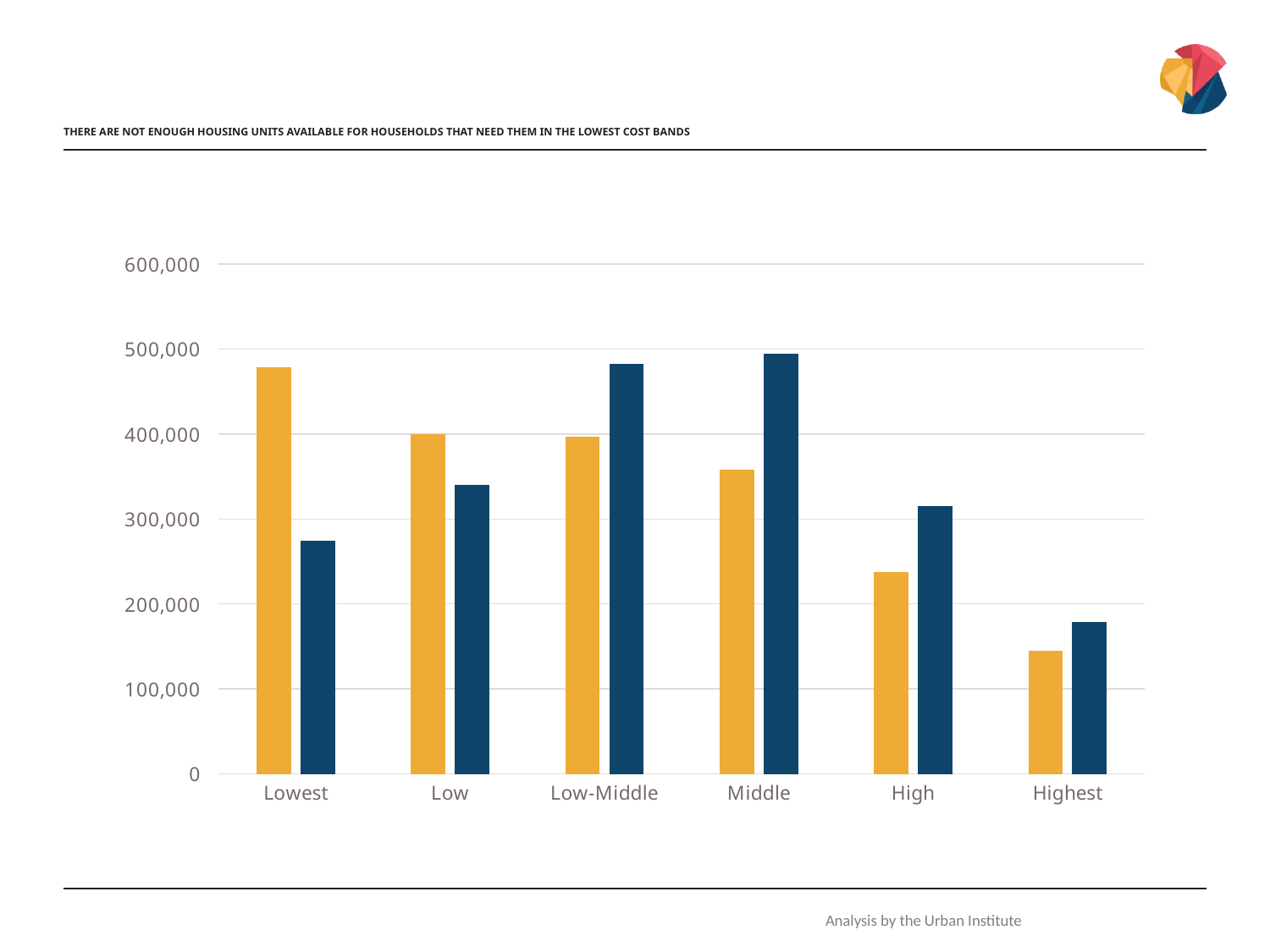
Is the orange bar for Highest greater or less than 200,000? less How many cost band categories are shown on the x axis? 6 For the Middle cost band, which bar is taller, the orange or the dark blue one? dark blue What kind of chart is shown on the slide? bar chart Who is credited with the analysis at the bottom of the slide? the Urban Institute Is the dark blue bar for Lowest greater or less than 300,000? less Do the orange bars generally rise or fall from Lowest to Highest? fall Which cost band has the shortest dark blue bar? Highest Which cost band has the tallest orange bar? Lowest Is the dark blue bar for Middle greater or less than 400,000? greater For the Lowest cost band, which bar is taller, the orange or the dark blue one? orange